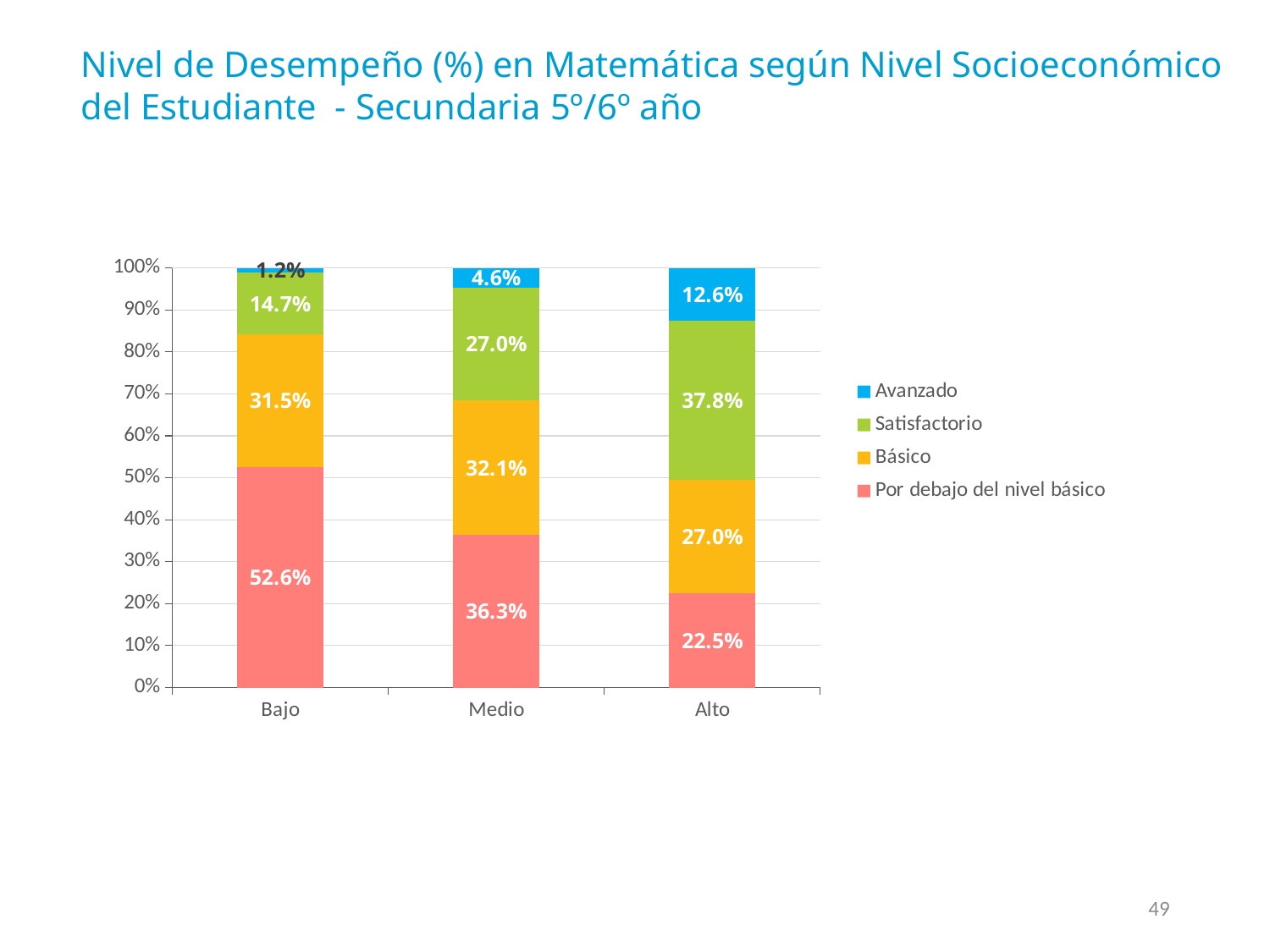
What is the 'Básico' value for the Alto group? 27.0% What is the difference between the 'Por debajo del nivel básico' values for Bajo and Alto? 30.1% How many series does the legend list? 4 What percentage of students in the Bajo group are 'Por debajo del nivel básico'? 52.6% Which is larger: the 'Básico' value for Medio or the 'Básico' value for Bajo? Medio What is the 'Avanzado' value for the Alto group? 12.6% What kind of chart is shown on the slide? Stacked bar chart Does the 'Satisfactorio' percentage rise or fall from Bajo to Alto? Rise Which socioeconomic group has the lowest 'Por debajo del nivel básico' percentage? Alto What is the 'Satisfactorio' value for the Medio group? 27.0% How many socioeconomic groups are shown on the x axis? 3 Which socioeconomic group has the highest 'Avanzado' percentage? Alto